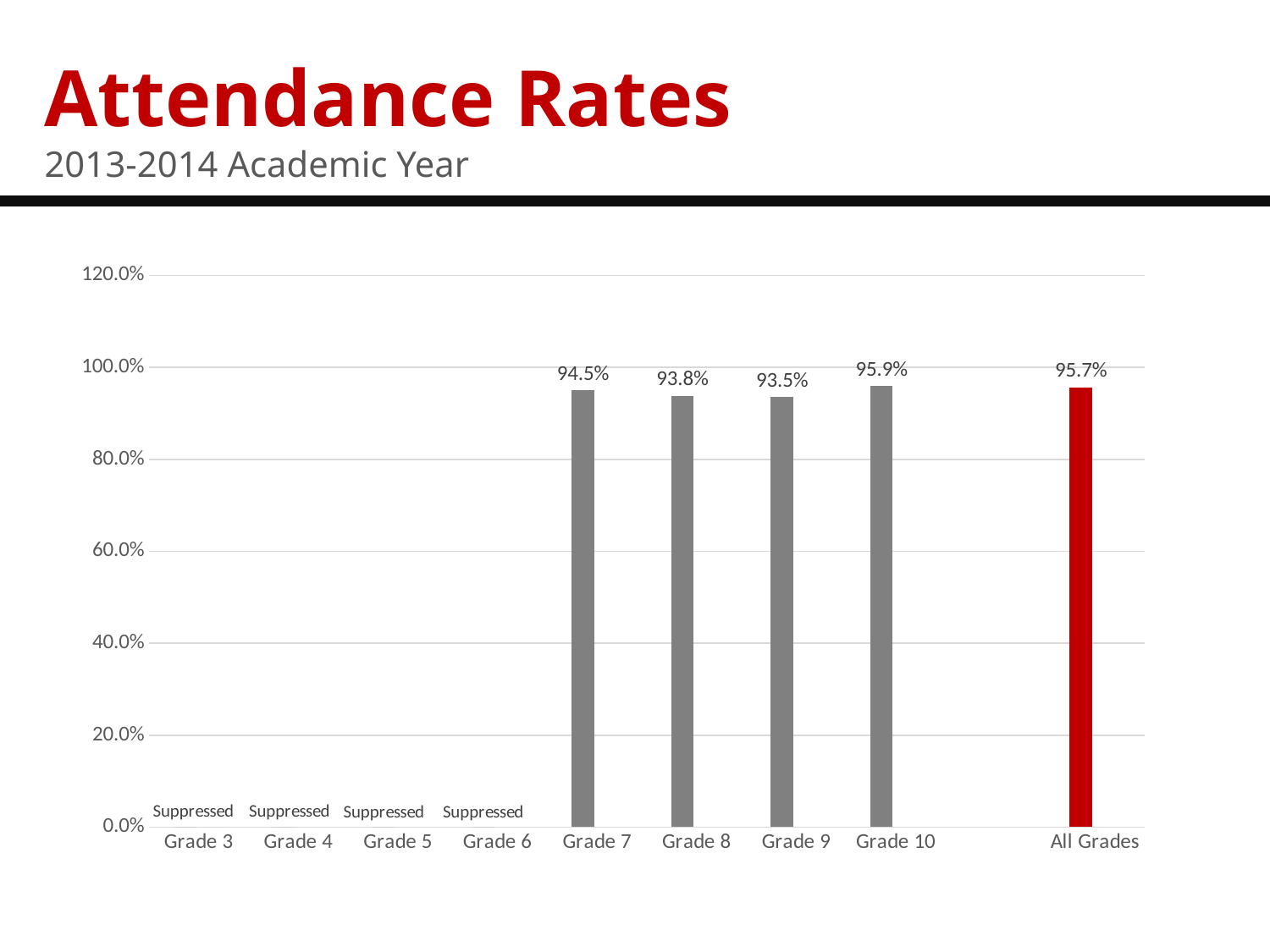
Is the attendance rate for Grade 8 greater or less than 100.0%? less What is the attendance rate for Grade 7? 94.5% What kind of chart is shown on the slide? bar chart What is the attendance rate for All Grades? 95.7% Which has a higher attendance rate, Grade 7 or Grade 8? Grade 7 What label is shown for Grade 3, Grade 4, Grade 5 and Grade 6 instead of a value? Suppressed How many categories are shown on the x axis? 9 What is the attendance rate for Grade 10? 95.9% What is the difference between the attendance rates for Grade 10 and Grade 9? 2.4% Which grade has the highest attendance rate among the plotted bars? Grade 10 Which grade has the lowest attendance rate among the plotted bars? Grade 9 What is the attendance rate for Grade 9? 93.5%